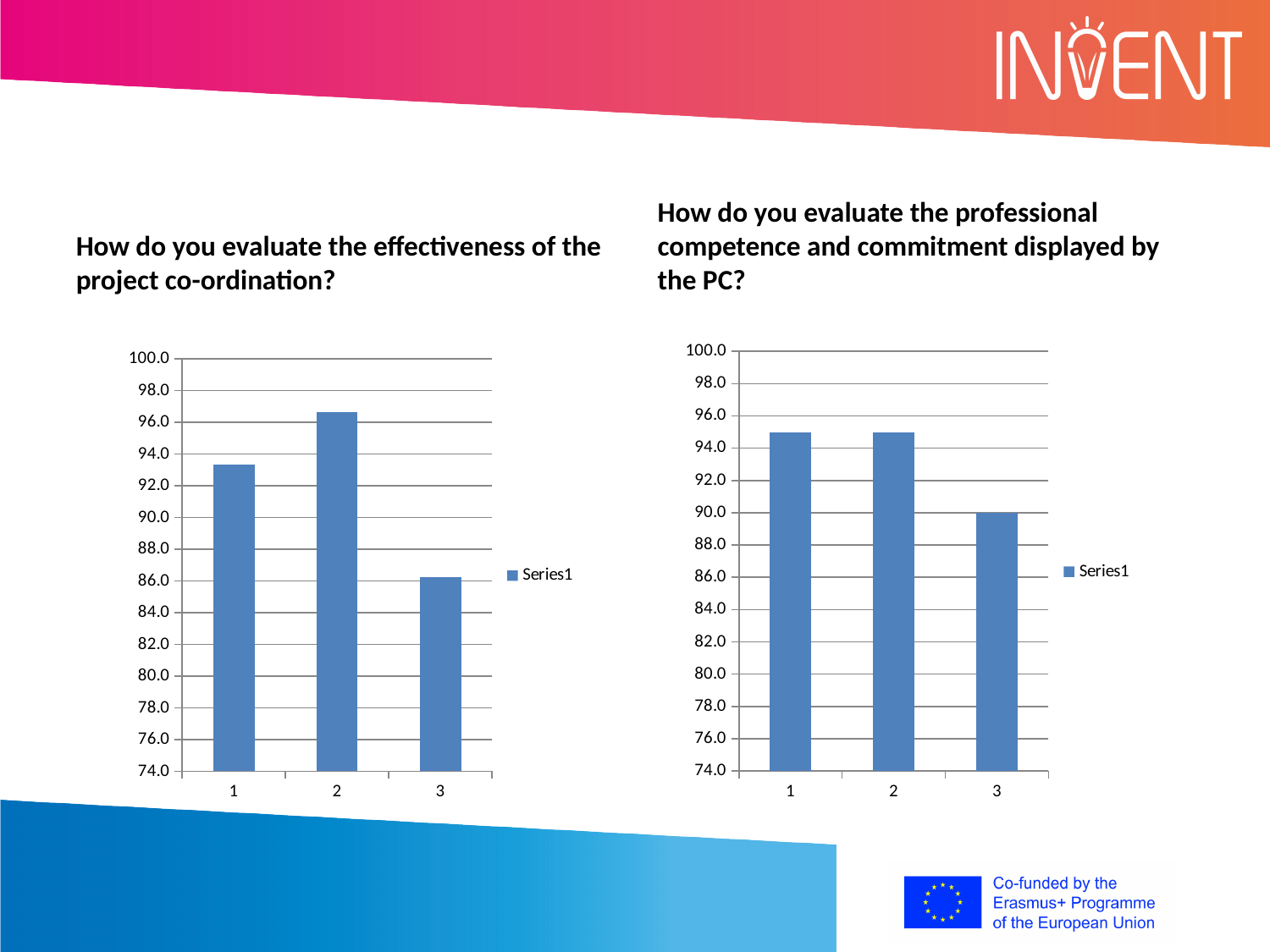
On the right chart (professional competence and commitment displayed by the PC), what is the value for category 3? 90.0 On the left chart (effectiveness of the project co-ordination), is the value for category 2 greater or less than 96.0? greater On the left chart (effectiveness of the project co-ordination), which is larger, the value for category 1 or category 3? 1 On the left chart (effectiveness of the project co-ordination), which category has the lowest value? 3 On the left chart (effectiveness of the project co-ordination), is the value for category 3 greater or less than 88.0? less How many series does the legend of the right chart (professional competence and commitment displayed by the PC) list? 1 How many categories are shown on the left chart (effectiveness of the project co-ordination)? 3 On the right chart (professional competence and commitment displayed by the PC), which is larger, the value for category 2 or category 3? 2 On the left chart (effectiveness of the project co-ordination), which category has the highest value? 2 On the right chart (professional competence and commitment displayed by the PC), is the value for category 1 greater or less than 94.0? greater What kind of chart is the left chart (effectiveness of the project co-ordination)? bar chart On the right chart (professional competence and commitment displayed by the PC), which category has the lowest value? 3